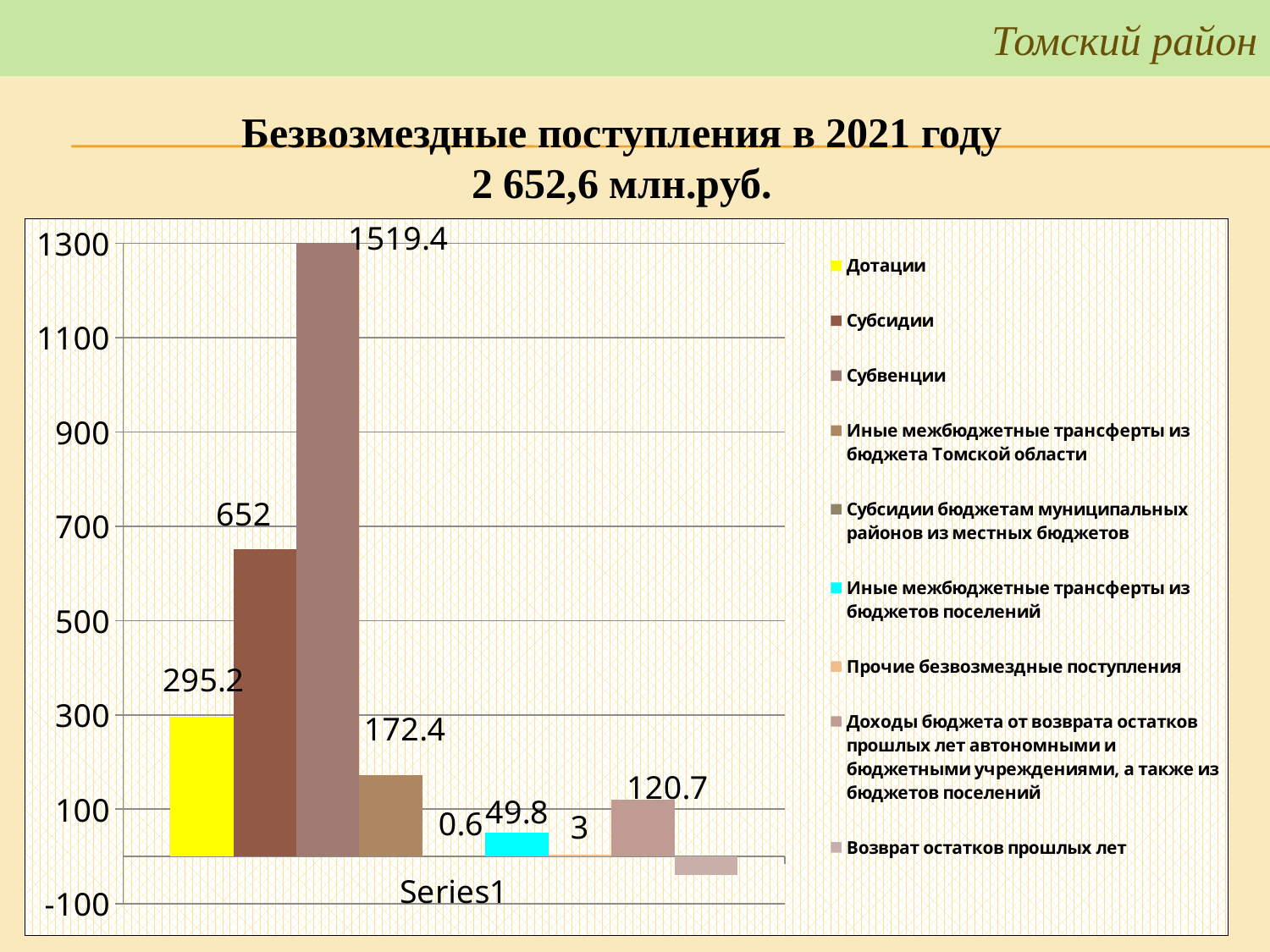
What is the value for Прочие безвозмездные поступления? 3 What type of chart is shown on the slide? bar chart How many series does the legend list? 9 What is the value for Иные межбюджетные трансферты из бюджетов поселений? 49.8 Which is larger, the value for Иные межбюджетные трансферты из бюджета Томской области or the value for Доходы бюджета от возврата остатков прошлых лет автономными и бюджетными учреждениями, а также из бюджетов поселений? Иные межбюджетные трансферты из бюджета Томской области Which series has the highest value? Субвенции What is the difference between the values for Субсидии and Дотации? 356.8 What is the value for Иные межбюджетные трансферты из бюджета Томской области? 172.4 What is the value for Субвенции? 1519.4 What is the title of the slide above the chart? Безвозмездные поступления в 2021 году 2 652,6 млн.руб. What is the value for Дотации? 295.2 What is the value for Субсидии? 652